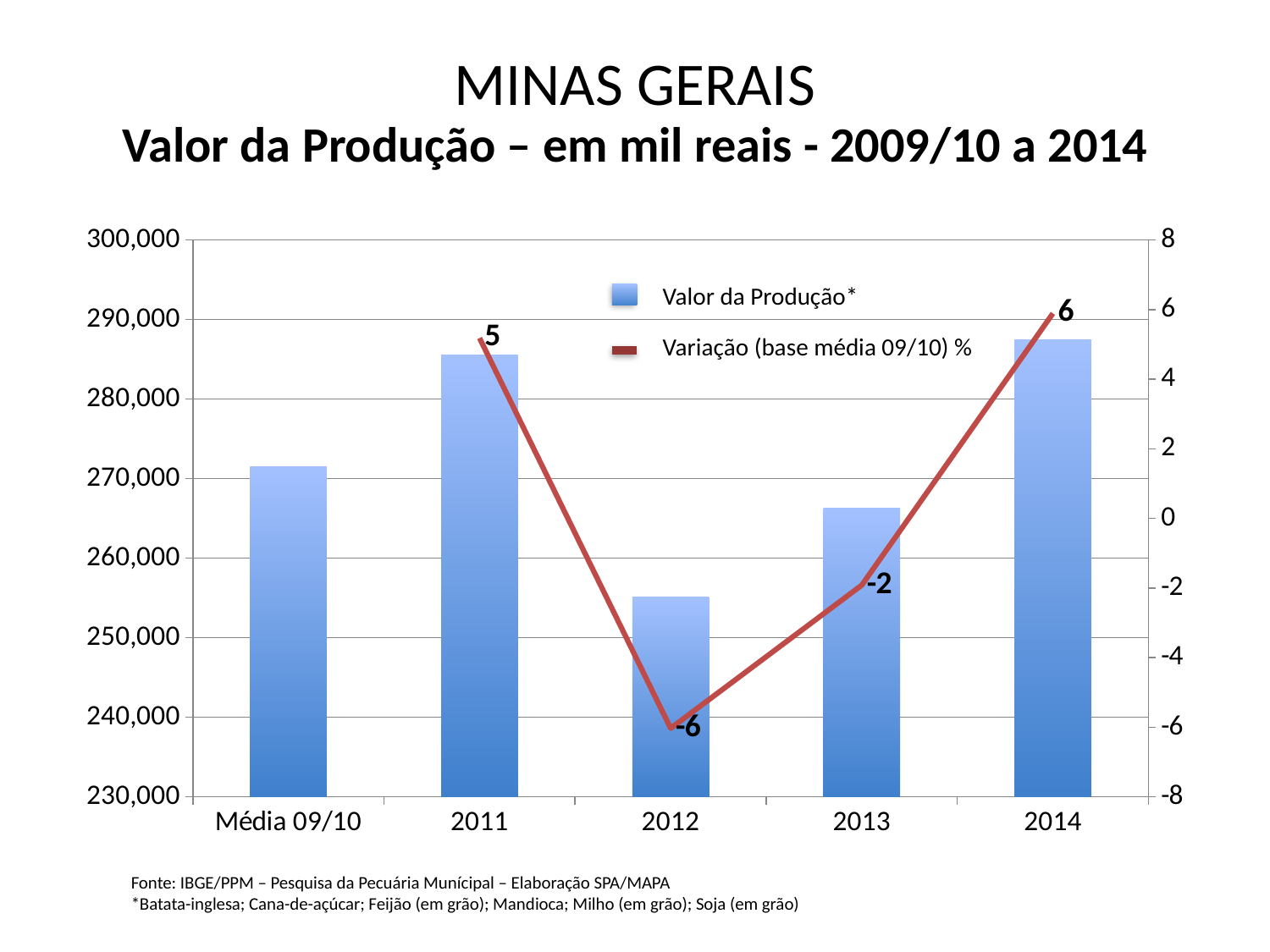
Is the Valor da Produção for 2011 greater or less than 280,000? greater What is the value of Variação (base média 09/10) % for 2013? -2 What is the difference between the Variação (base média 09/10) % for 2011 and 2012? 11 Is the Valor da Produção for 2012 greater or less than 260,000? less Which year has the highest Variação (base média 09/10) %? 2014 How many categories are shown on the x axis? 5 How many series does the legend list? 2 What is the value of Variação (base média 09/10) % for 2014? 6 What is the value of Variação (base média 09/10) % for 2012? -6 What is the value of Variação (base média 09/10) % for 2011? 5 Which category has the lowest Valor da Produção bar? 2012 Which year has the lowest Variação (base média 09/10) %? 2012